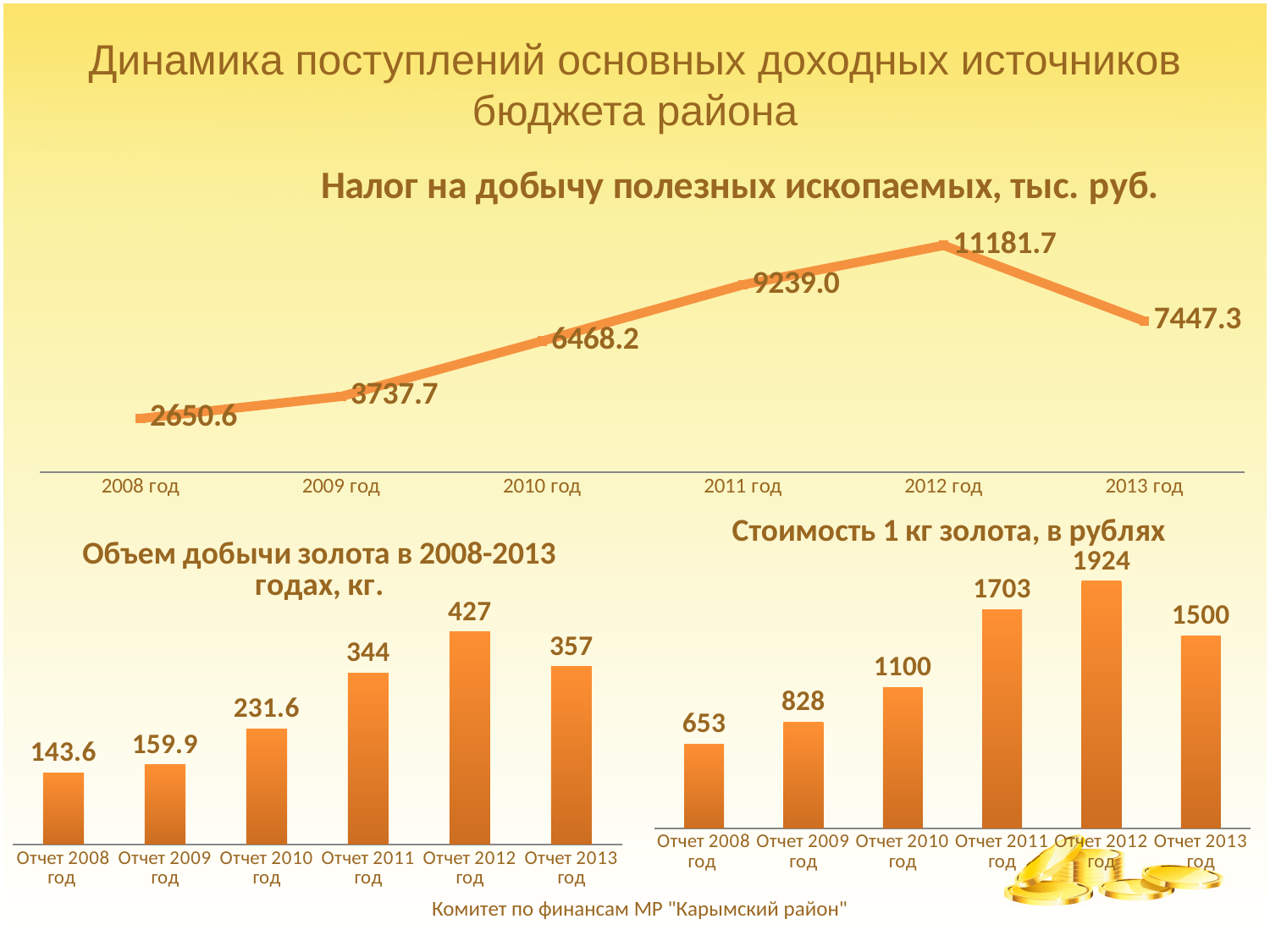
In the bottom-left chart 'Объем добычи золота в 2008-2013 годах, кг.', what is the difference between Отчет 2012 год and Отчет 2013 год? 70 In the bottom-left chart 'Объем добычи золота в 2008-2013 годах, кг.', what is the value for Отчет 2010 год? 231.6 In the top chart 'Налог на добычу полезных ископаемых, тыс. руб.', what is the value for 2012 год? 11181.7 In the top chart 'Налог на добычу полезных ископаемых, тыс. руб.', what is the difference between the 2012 год and 2013 год values? 3734.4 What kind of chart is the bottom-left chart 'Объем добычи золота в 2008-2013 годах, кг.'? bar chart What kind of chart is the top chart 'Налог на добычу полезных ископаемых, тыс. руб.'? line chart In the bottom-right chart 'Стоимость 1 кг золота, в рублях', which is larger: Отчет 2009 год or Отчет 2010 год? Отчет 2010 год In the top chart 'Налог на добычу полезных ископаемых, тыс. руб.', which year has the lowest value? 2008 год In the bottom-left chart 'Объем добычи золота в 2008-2013 годах, кг.', which category has the highest value? Отчет 2012 год In the top chart 'Налог на добычу полезных ископаемых, тыс. руб.', how many data points are plotted? 6 In the bottom-right chart 'Стоимость 1 кг золота, в рублях', what is the value for Отчет 2011 год? 1703 In the bottom-right chart 'Стоимость 1 кг золота, в рублях', what is the difference between Отчет 2012 год and Отчет 2008 год? 1271